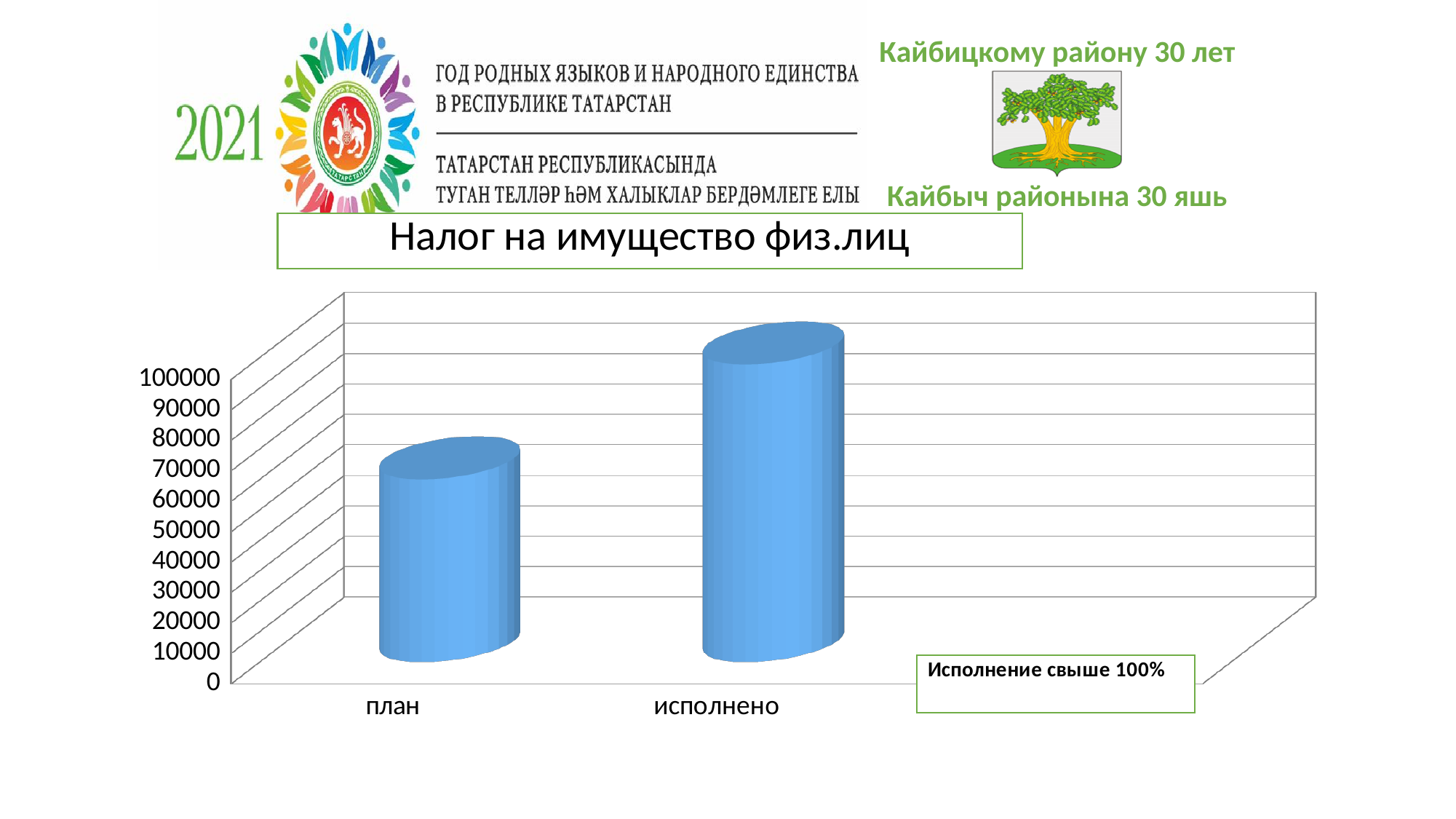
Which category has the higher bar, план or исполнено? исполнено Which category has the lowest value on the chart? план Is the value for план greater or less than 50000? greater What is the title shown above the chart? Налог на имущество физ.лиц Do the values rise or fall from план to исполнено along the x axis? rise How many categories are plotted on the chart? 2 Is the value for план greater or less than 90000? less What is the highest tick value shown on the vertical axis? 100000 What kind of chart is shown on the slide? bar chart Is the value for исполнено greater or less than 80000? greater What does the text box next to the chart say about execution? Исполнение свыше 100% Which category has the highest value on the chart? исполнено